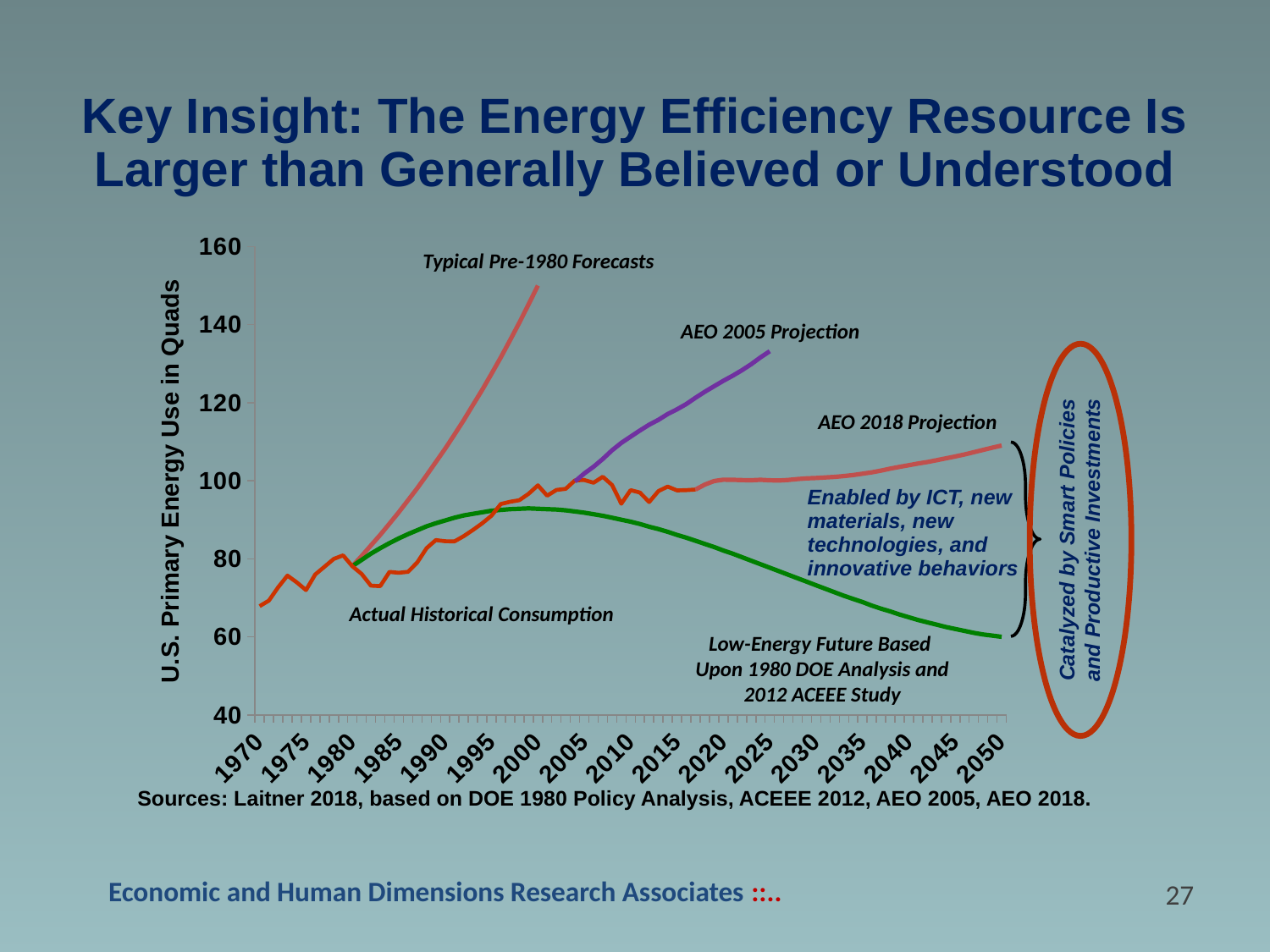
Is the value of the Typical Pre-1980 Forecasts line in 2000 greater or less than 140? greater How many year labels are shown along the x axis of the chart? 17 Is the value of the Low-Energy Future line in 2050 greater or less than 80? less Is the value of the AEO 2018 Projection line in 2050 greater or less than 100? greater Does the Low-Energy Future line rise or fall between 2020 and 2050? fall What is the label on the vertical axis of the chart? U.S. Primary Energy Use in Quads In 2050, which line is higher: the AEO 2018 Projection or the Low-Energy Future line? AEO 2018 Projection How many labeled lines (series) are plotted on the chart? 5 Does the Typical Pre-1980 Forecasts line rise or fall from 1980 to 2000? rise What kind of chart is shown on the slide? line chart